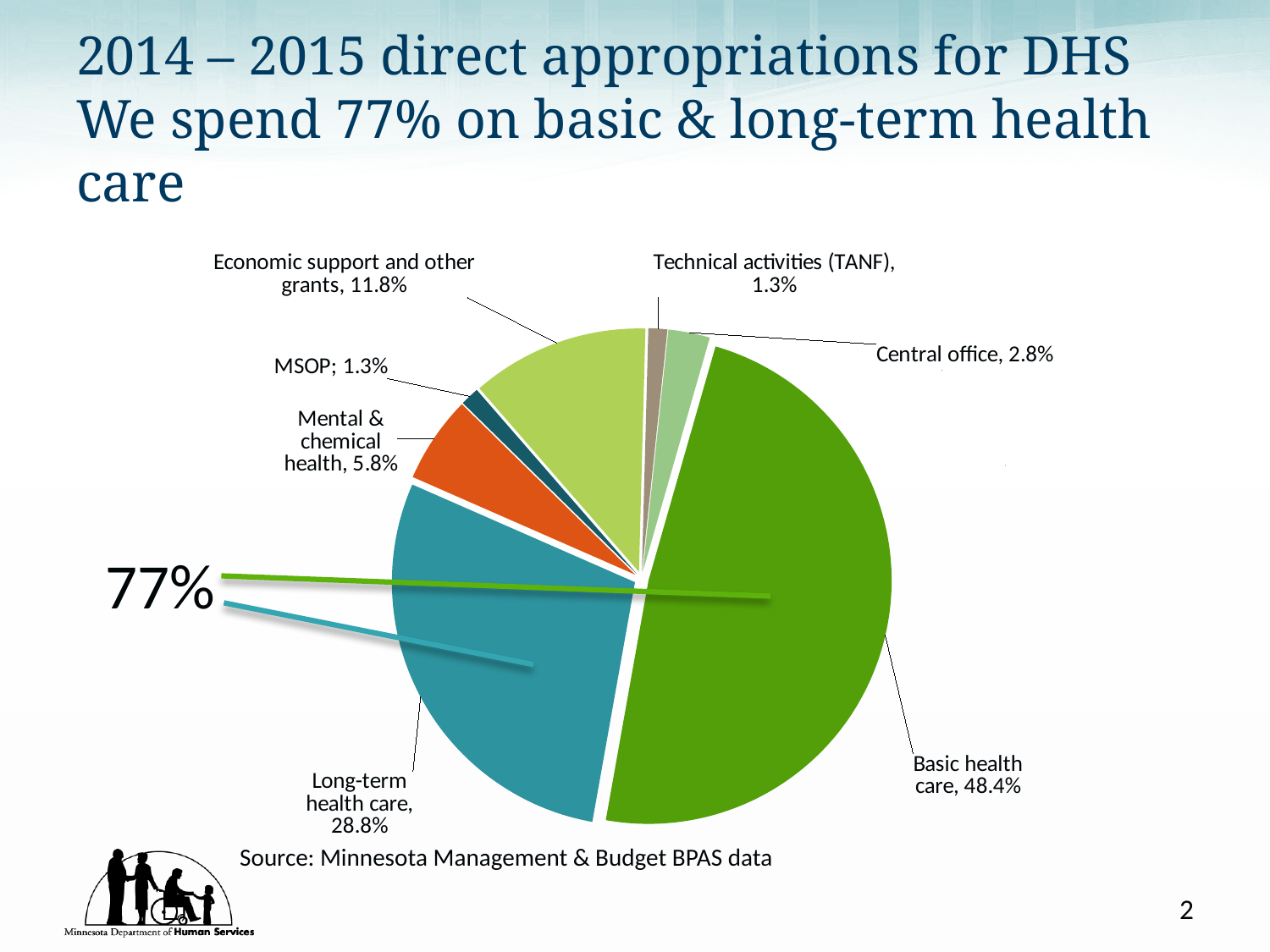
What percentage is shown for Mental & chemical health? 5.8% By how many percentage points does Basic health care exceed Long-term health care? 19.6 percentage points What percentage is shown for Central office? 2.8% What percentage is shown for Long-term health care? 28.8% According to the slide title, what combined share is spent on basic & long-term health care? 77% What type of chart is shown on the slide? Pie chart What percentage is shown for Technical activities (TANF)? 1.3% Which category has the largest slice of the pie? Basic health care Which is larger, the share for Long-term health care or the share for Economic support and other grants? Long-term health care What share of the 2014–2015 direct appropriations goes to Basic health care? 48.4% What percentage is shown for Economic support and other grants? 11.8% How many slices does the pie chart have? 7